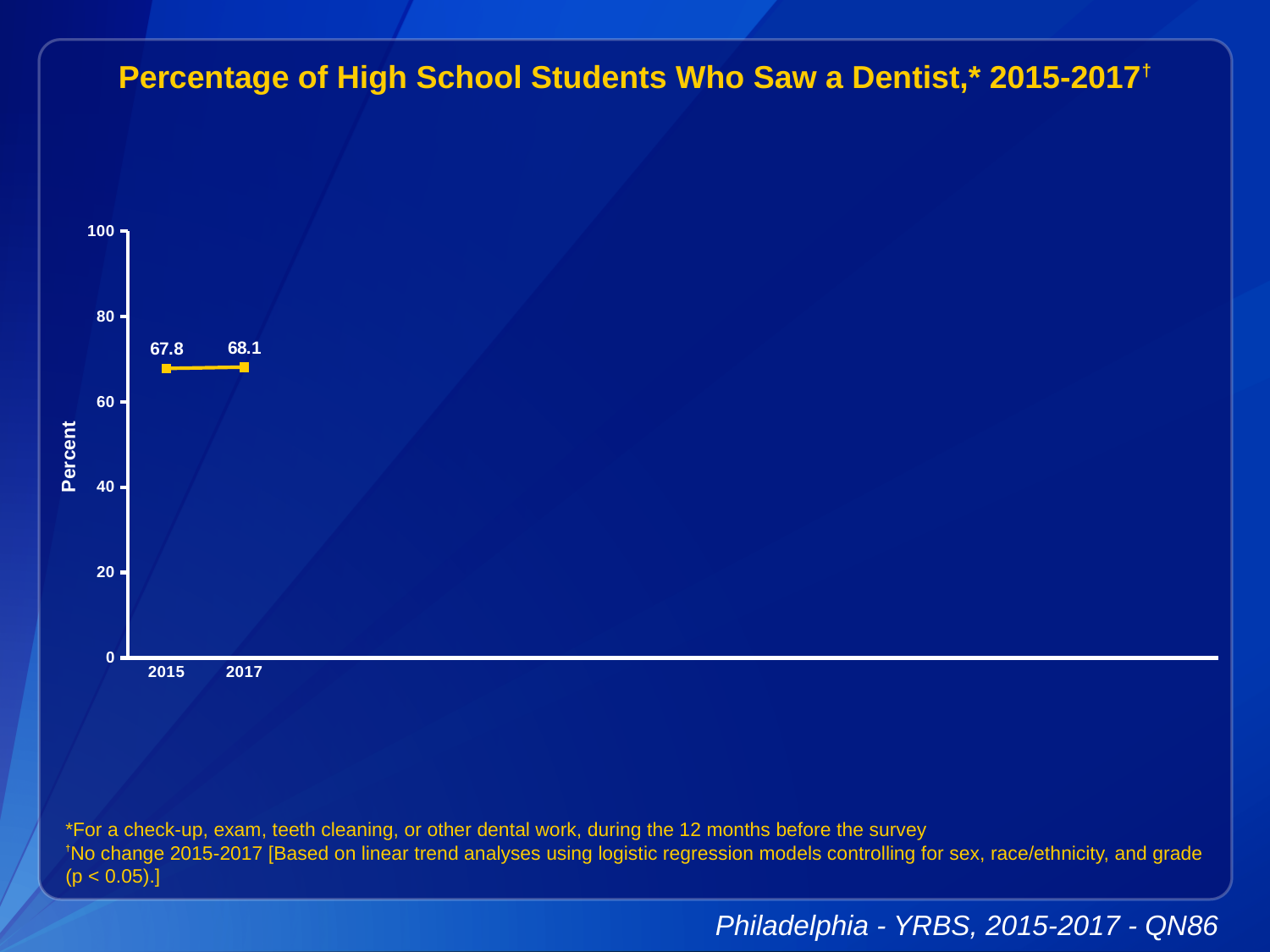
What percentage of high school students saw a dentist in 2017? 68.1 How many years are plotted on the chart? 2 What percentage of high school students saw a dentist in 2015? 67.8 Do the values rise or fall from 2015 to 2017? rise Which year has the higher value, 2015 or 2017? 2017 What kind of chart is shown on the slide? line chart Is the value for 2017 greater or less than 80? less What is the maximum value shown on the y axis? 100 What is the label on the y axis of the chart? Percent What is the difference between the 2017 and 2015 values? 0.3 Is the value for 2015 greater or less than 60? greater